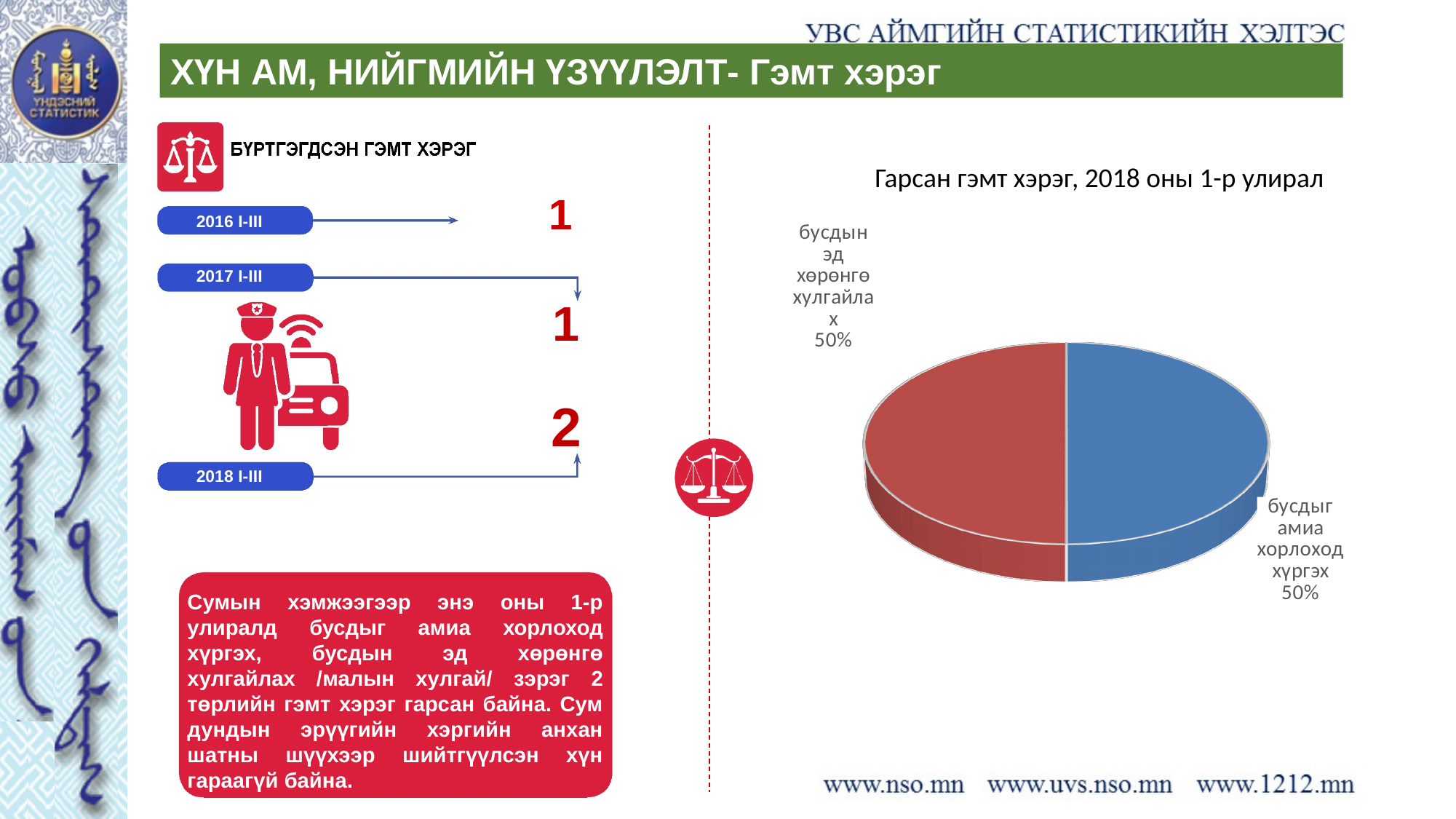
In the pie chart, is the share for 'бусдыг амиа хорлоход хүргэх' larger, smaller, or equal to the share for 'бусдын эд хөрөнгө хулгайлах'? equal What is the title of the pie chart? Гарсан гэмт хэрэг, 2018 оны 1-р улирал What share of the pie chart is labelled 'бусдын эд хөрөнгө хулгайлах'? 50% What is the difference between the two slice shares in the pie chart? 0% How many slices does the pie chart have? 2 What kind of chart is shown on the right side of the slide? pie chart What colour is the 'бусдыг амиа хорлоход хүргэх' slice in the pie chart? blue What share of the pie chart is labelled 'бусдыг амиа хорлоход хүргэх'? 50%